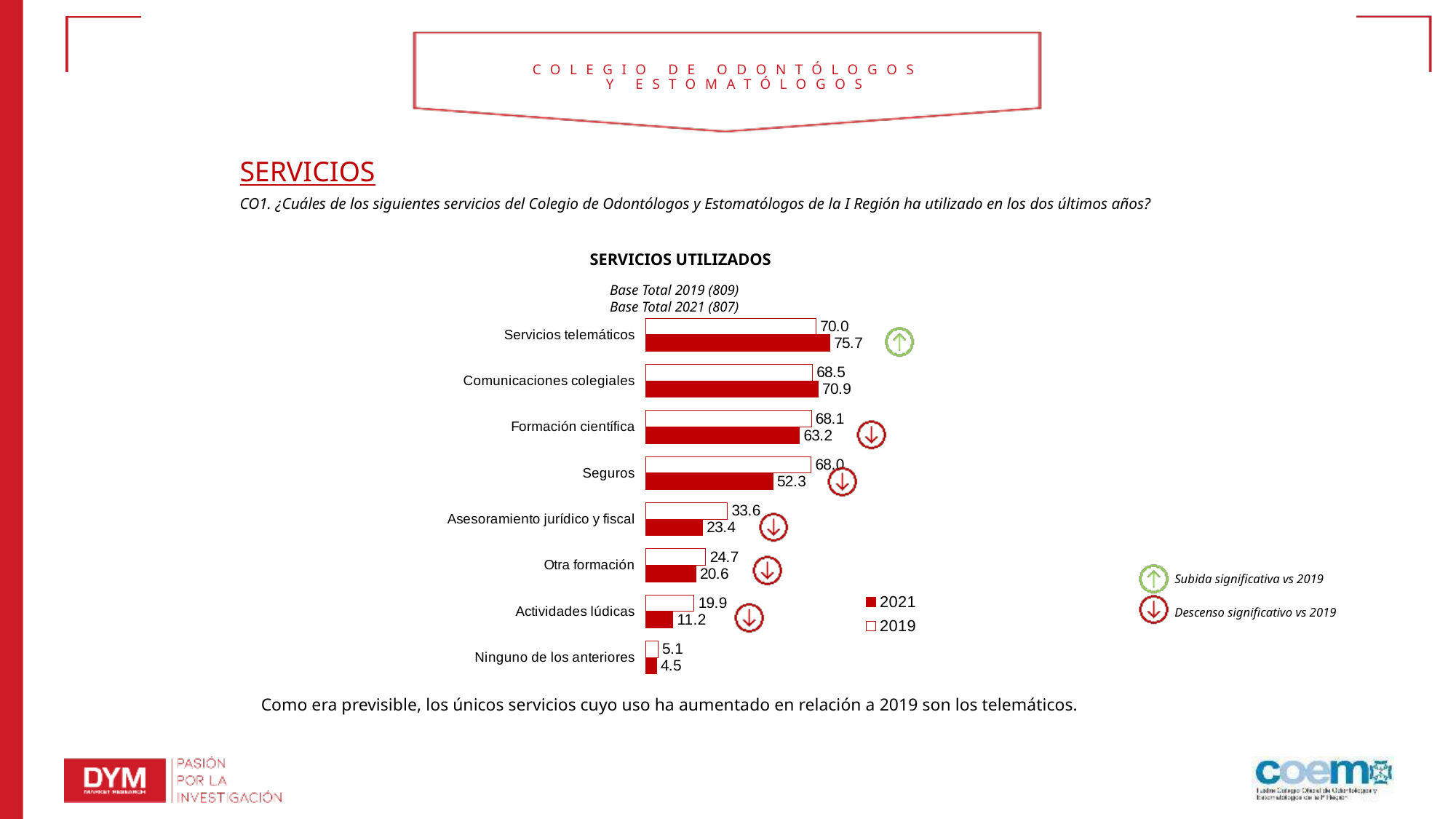
What is the 2021 value for Servicios telemáticos? 75.7 Which category has the highest 2021 value? Servicios telemáticos What is the title of the chart? SERVICIOS UTILIZADOS What is the difference between the 2019 and 2021 values for Seguros? 15.7 What kind of chart is shown on the slide? Bar chart Which series is shown with solid red bars? 2021 What is the 2019 value for Seguros? 68.0 How many series does the legend list? 2 Which category has the lowest 2019 value? Ninguno de los anteriores How many categories are shown in the chart? 8 Which is larger for Formación científica, the 2019 value or the 2021 value? 2019 What is the 2021 value for Asesoramiento jurídico y fiscal? 23.4